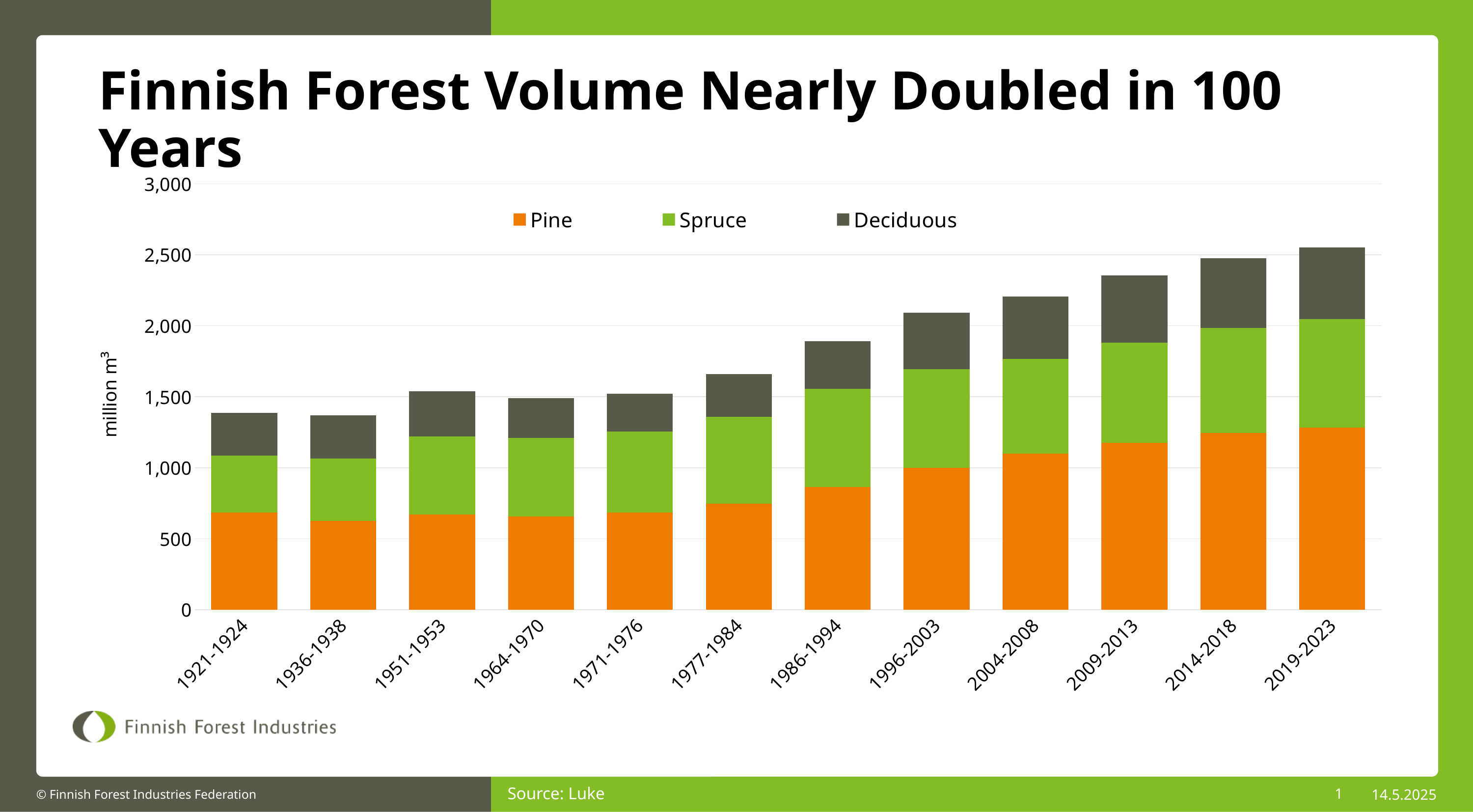
Is the total forest volume for 1986-1994 greater or less than 2,000? less How many series does the legend list? 3 Is the total forest volume for 2019-2023 greater or less than 2,500? greater Which has the larger total forest volume, 1971-1976 or 1977-1984? 1977-1984 Is the total forest volume for 1921-1924 greater or less than 1,500? less What unit is shown on the y axis of the chart? million m³ What kind of chart is shown on the slide? Stacked bar chart Which period has the highest total forest volume? 2019-2023 How many time periods are shown on the x axis? 12 Do the total forest volumes generally rise or fall from 1921-1924 to 2019-2023? rise